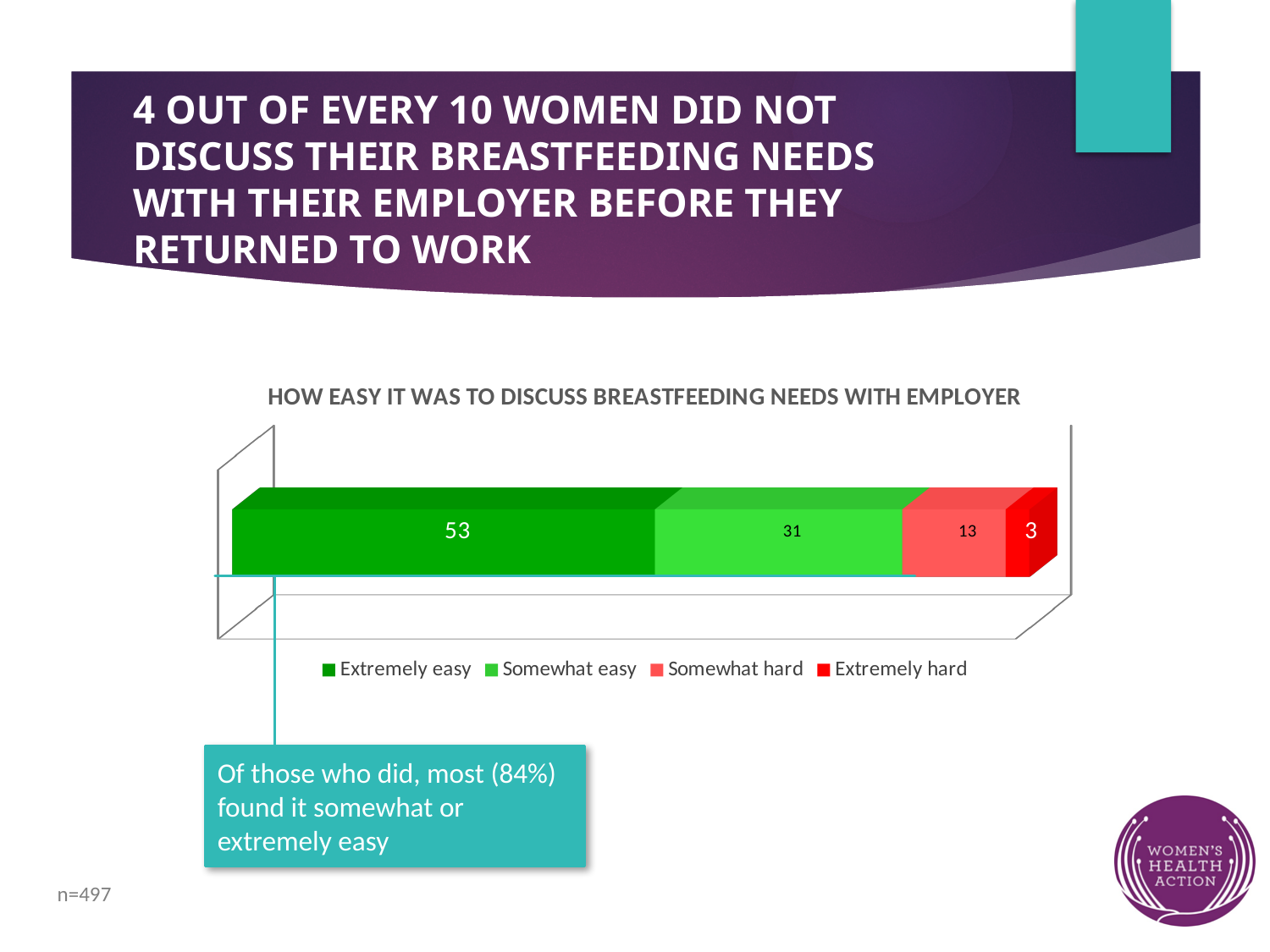
How many series does the legend list? 4 Which is larger, the value for Somewhat easy or the value for Somewhat hard? Somewhat easy What is the value for Somewhat hard? 13 What is the total of the stacked bar? 100 What is the title of the chart? HOW EASY IT WAS TO DISCUSS BREASTFEEDING NEEDS WITH EMPLOYER Which series has the lowest value? Extremely hard What is the value for Somewhat easy? 31 What is the value for Extremely easy? 53 What kind of chart is shown? Stacked bar chart Which series has the highest value? Extremely easy What is the value for Extremely hard? 3 What is the difference between the values for Extremely easy and Somewhat easy? 22